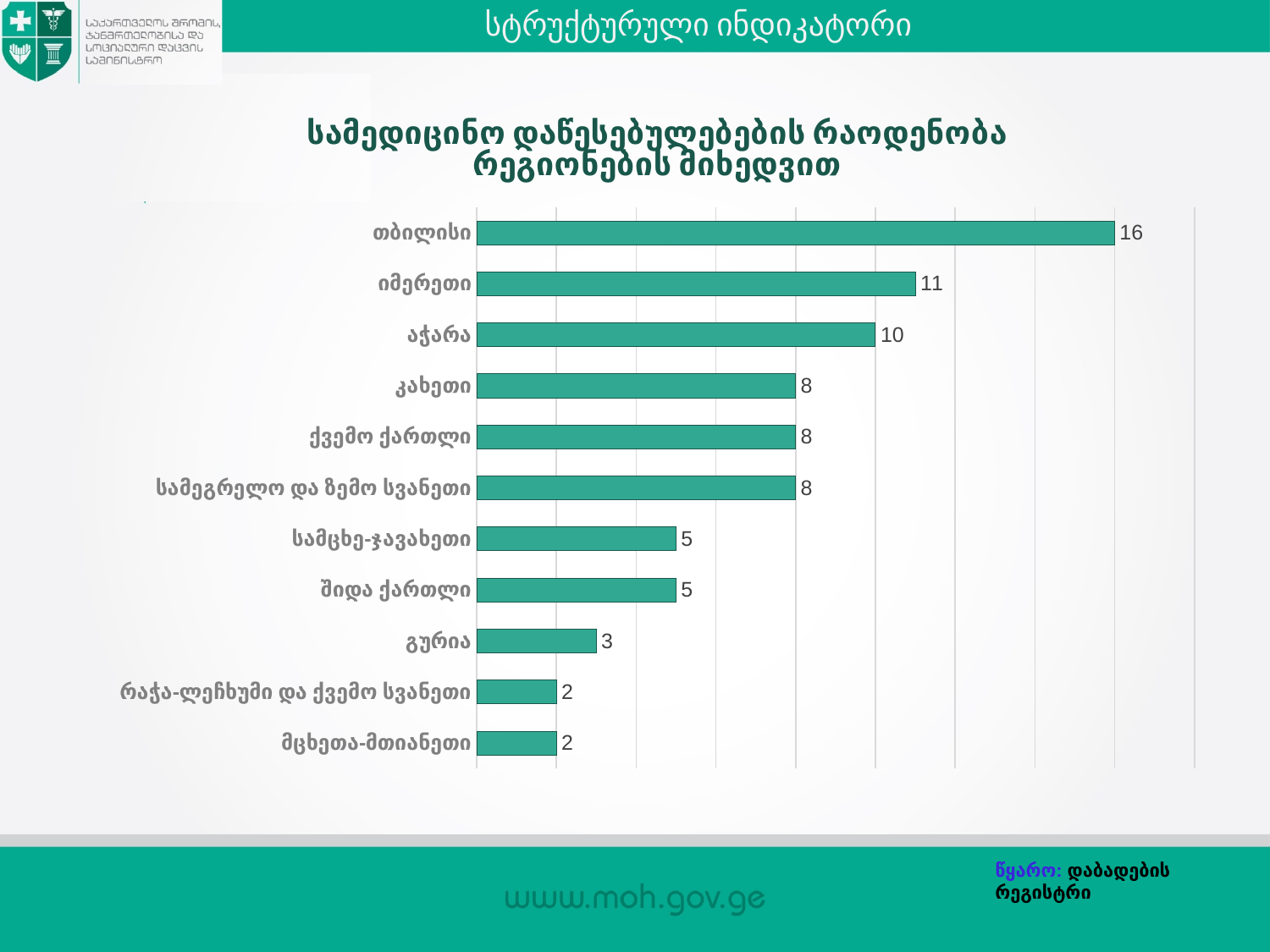
What is the value for აჭარა? 10 What is the title of the chart? სამედიცინო დაწესებულებების რაოდენობა რეგიონების მიხედვით What is the difference between the values for თბილისი and იმერეთი? 5 What is the value for გურია? 3 What is the value for სამცხე-ჯავახეთი? 5 What is the value for იმერეთი? 11 What is the difference between the values for აჭარა and გურია? 7 Which is larger, the value for კახეთი or the value for შიდა ქართლი? კახეთი What kind of chart is shown on the slide? bar chart What is the value for თბილისი? 16 How many regions are shown in the chart? 11 Which region has the highest value? თბილისი